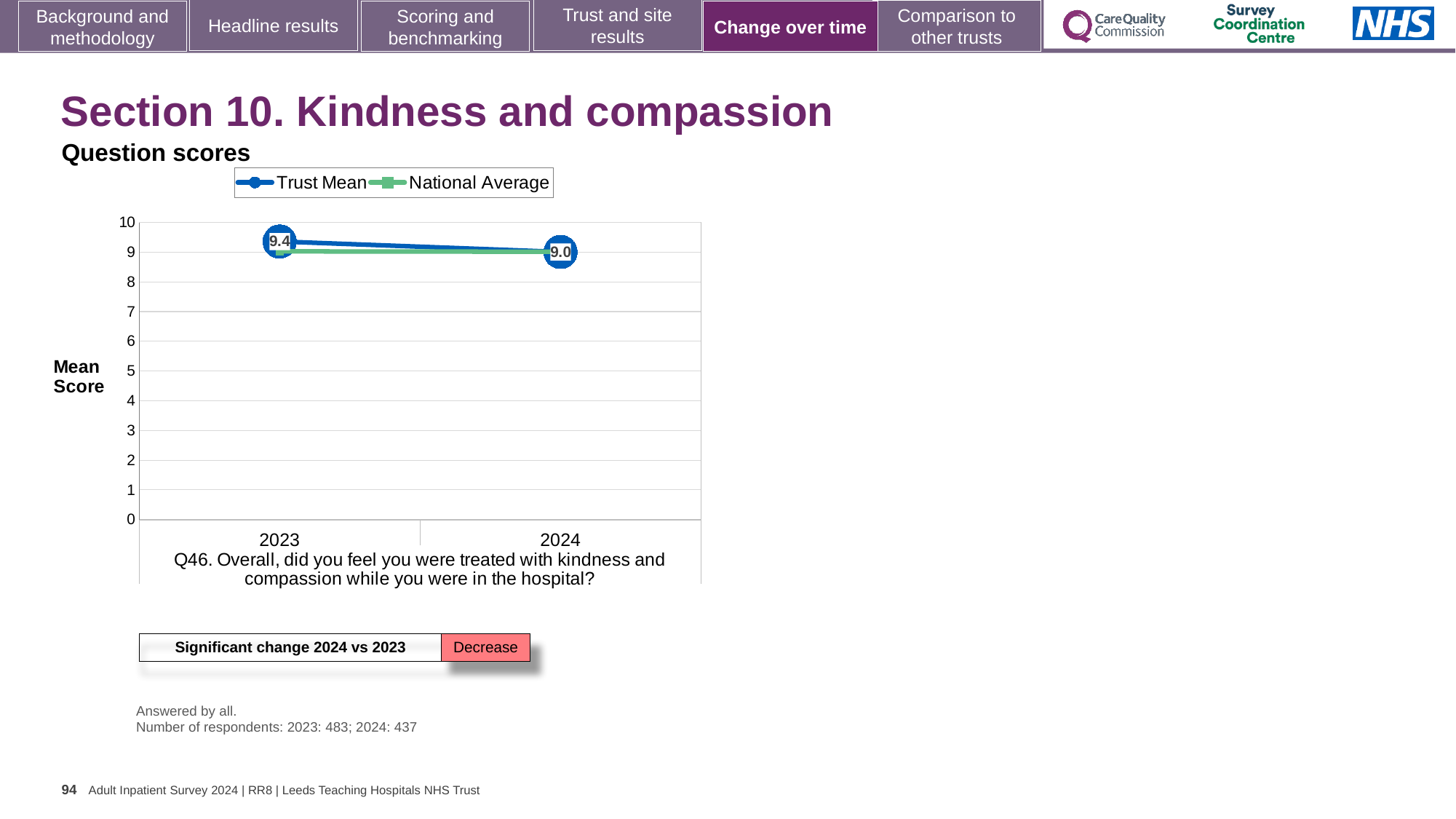
What kind of chart is shown on the slide? line chart Does the Trust Mean score rise or fall from 2023 to 2024? fall Is the National Average value for 2023 greater or less than 8? greater What is the label on the y axis of the chart? Mean Score By how much did the Trust Mean score fall from 2023 to 2024? 0.4 What is the Trust Mean score for 2023? 9.4 What is the Trust Mean score for 2024? 9.0 Which year has the higher Trust Mean score, 2023 or 2024? 2023 How many years are plotted on the x axis? 2 What are the two series named in the chart legend? Trust Mean and National Average How many series does the legend list? 2 In which year is the Trust Mean score highest? 2023